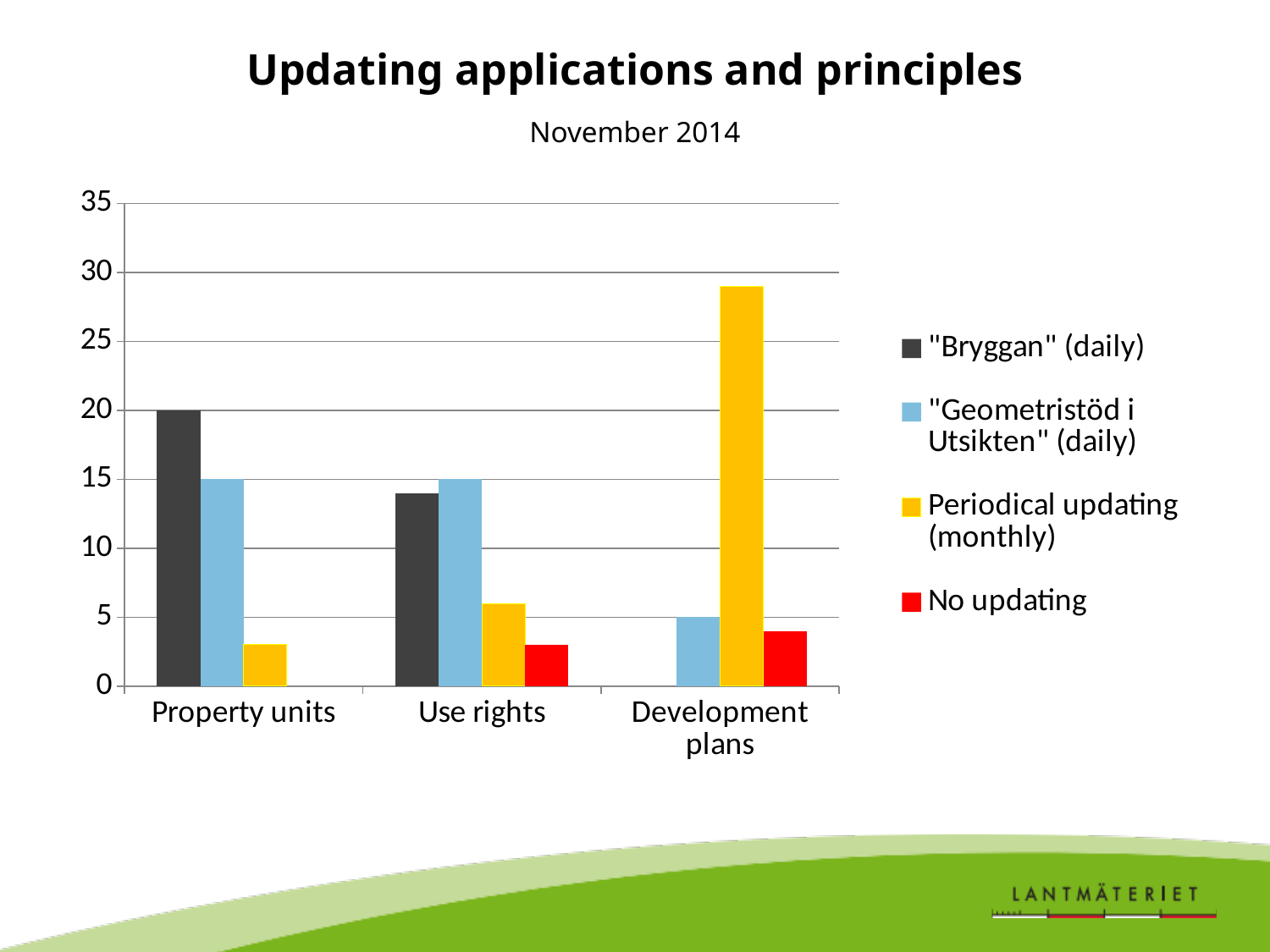
How many series does the chart's legend list? 4 Is the value of Periodical updating (monthly) for Property units greater or less than 5? less Which series has the highest value for Development plans? Periodical updating (monthly) Which is larger: "Bryggan" (daily) for Property units or "Bryggan" (daily) for Use rights? Property units What is the subtitle shown below the chart title? November 2014 What type of chart is shown on the slide? Bar chart Is the value of Periodical updating (monthly) for Development plans greater or less than 25? greater What is the value of "Bryggan" (daily) for Property units? 20 How many categories are shown on the x axis of the chart? 3 Is the value of "Bryggan" (daily) for Use rights greater or less than 10? greater What is the value of "Geometristöd i Utsikten" (daily) for Use rights? 15 What is the value of "Geometristöd i Utsikten" (daily) for Development plans? 5